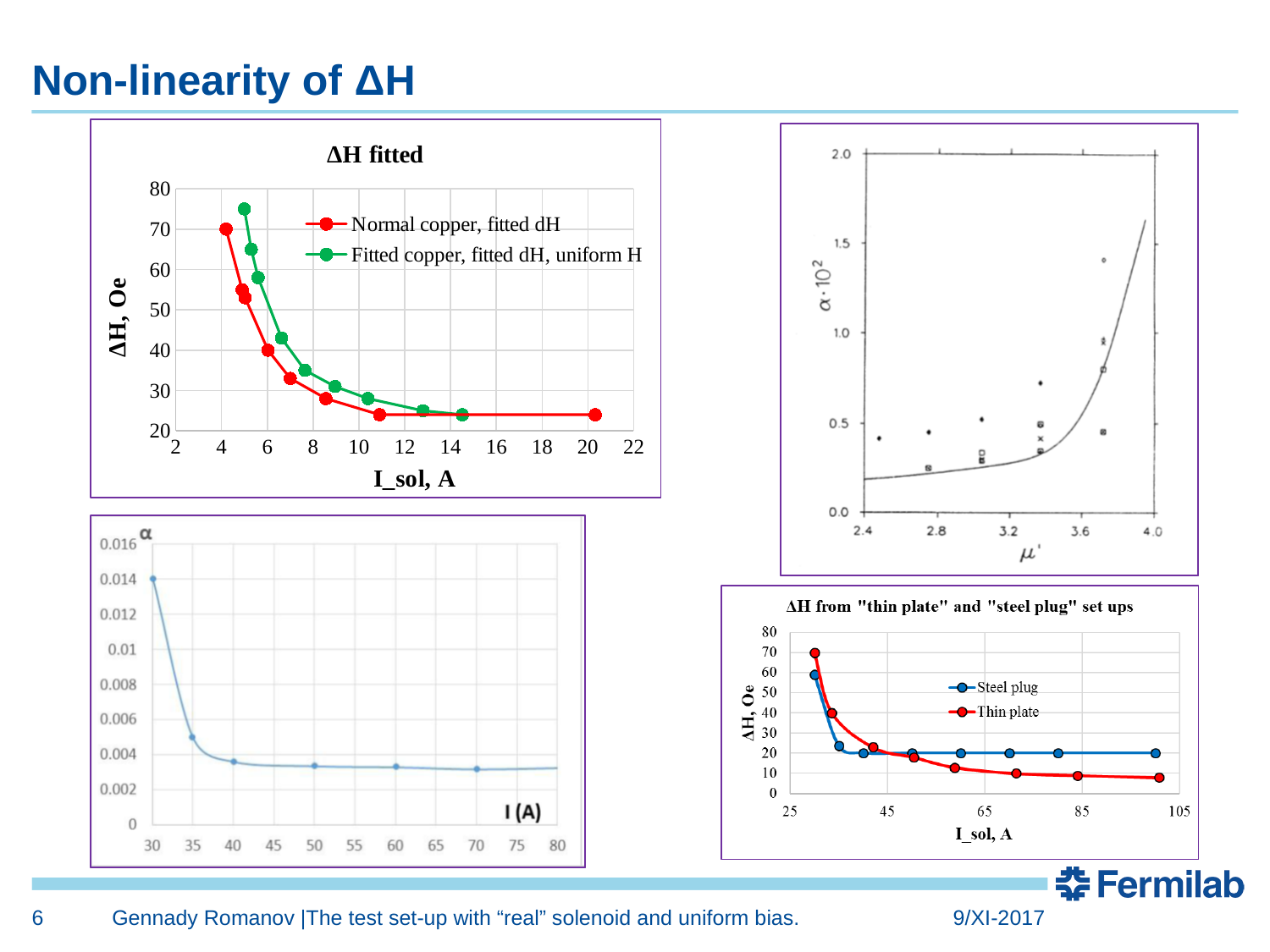
In the "ΔH fitted" chart, is the ΔH value of the last "Normal copper, fitted dH" point (near I_sol = 20 A) greater or less than 30? less In the "ΔH fitted" chart, what are the two legend entries? Normal copper, fitted dH; Fitted copper, fitted dH, uniform H In the chart titled "ΔH from "thin plate" and "steel plug" set ups", is the Thin plate value at I_sol = 100 A greater or less than 20? less In the chart titled "ΔH from "thin plate" and "steel plug" set ups", how many series does the legend list? 2 In the bottom-left α chart, how many data points are plotted? 6 In the "ΔH fitted" chart, do the ΔH values rise or fall as I_sol increases? fall In the bottom-left α chart, is the value of α at I = 30 A greater or less than 0.012? greater In the "ΔH fitted" chart, which series has the higher ΔH at I_sol = 6 A? Fitted copper, fitted dH, uniform H In the "ΔH fitted" chart, what kind of chart is shown? line chart In the chart titled "ΔH from "thin plate" and "steel plug" set ups", which series has the higher ΔH at I_sol = 100 A? Steel plug In the "ΔH fitted" chart, how many series does the legend list? 2 In the bottom-left α chart, what is the x-axis label? I (A)